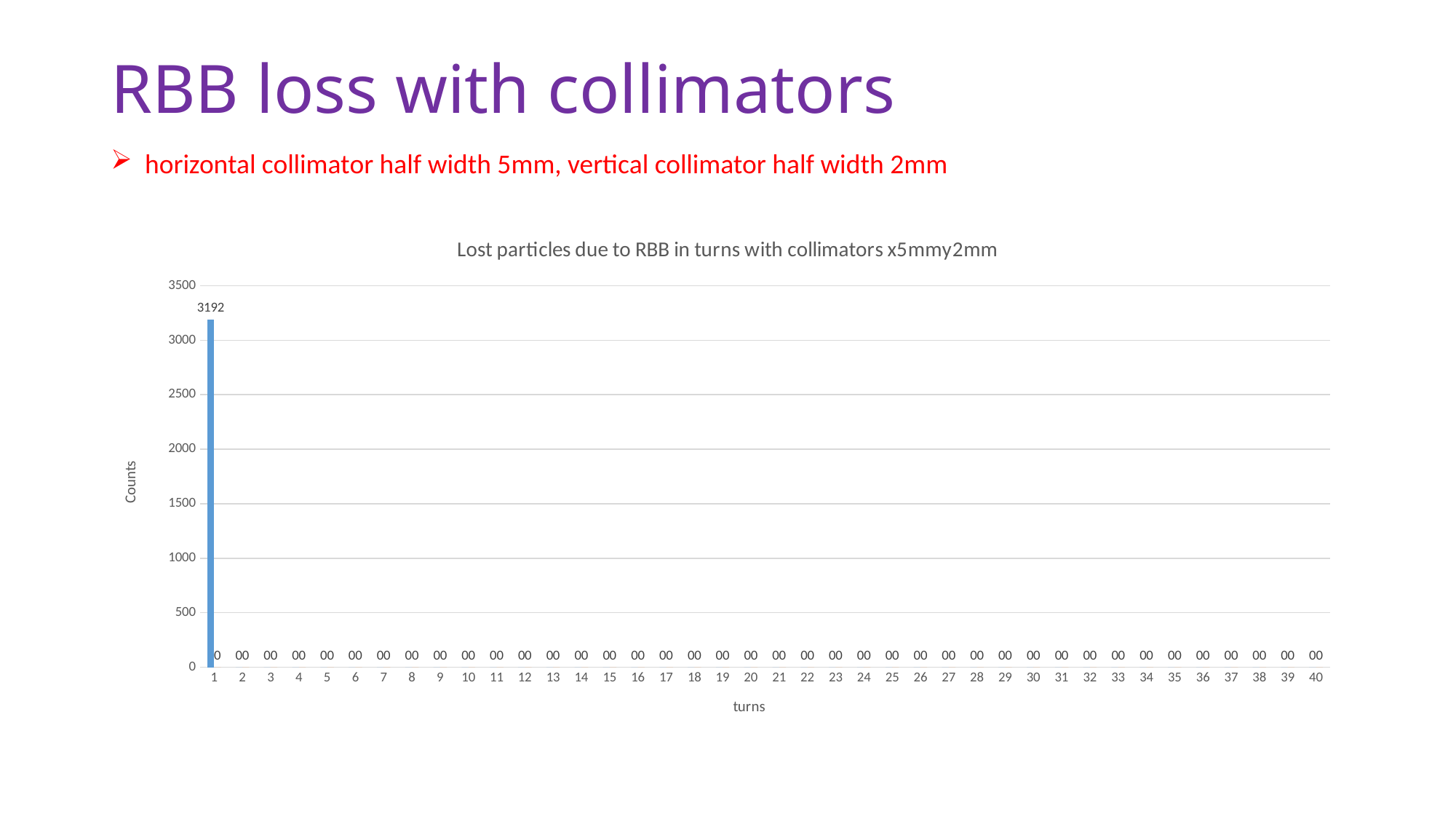
What is the value plotted for turn 1? 3192 What is the label of the vertical axis of the chart? Counts What is the title of the chart? Lost particles due to RBB in turns with collimators x5mmy2mm Is the value for turn 1 greater or less than 3000? greater What is the value plotted for turn 40? 0 How many turns are shown along the x axis? 40 Which has the larger count, turn 1 or turn 2? turn 1 What kind of chart is shown on the slide? bar chart What is the value plotted for turn 10? 0 What is the difference between the count at turn 1 and the count at turn 2? 3192 Do the counts rise or fall from turn 1 to turn 2? fall Which turn has the highest count? 1